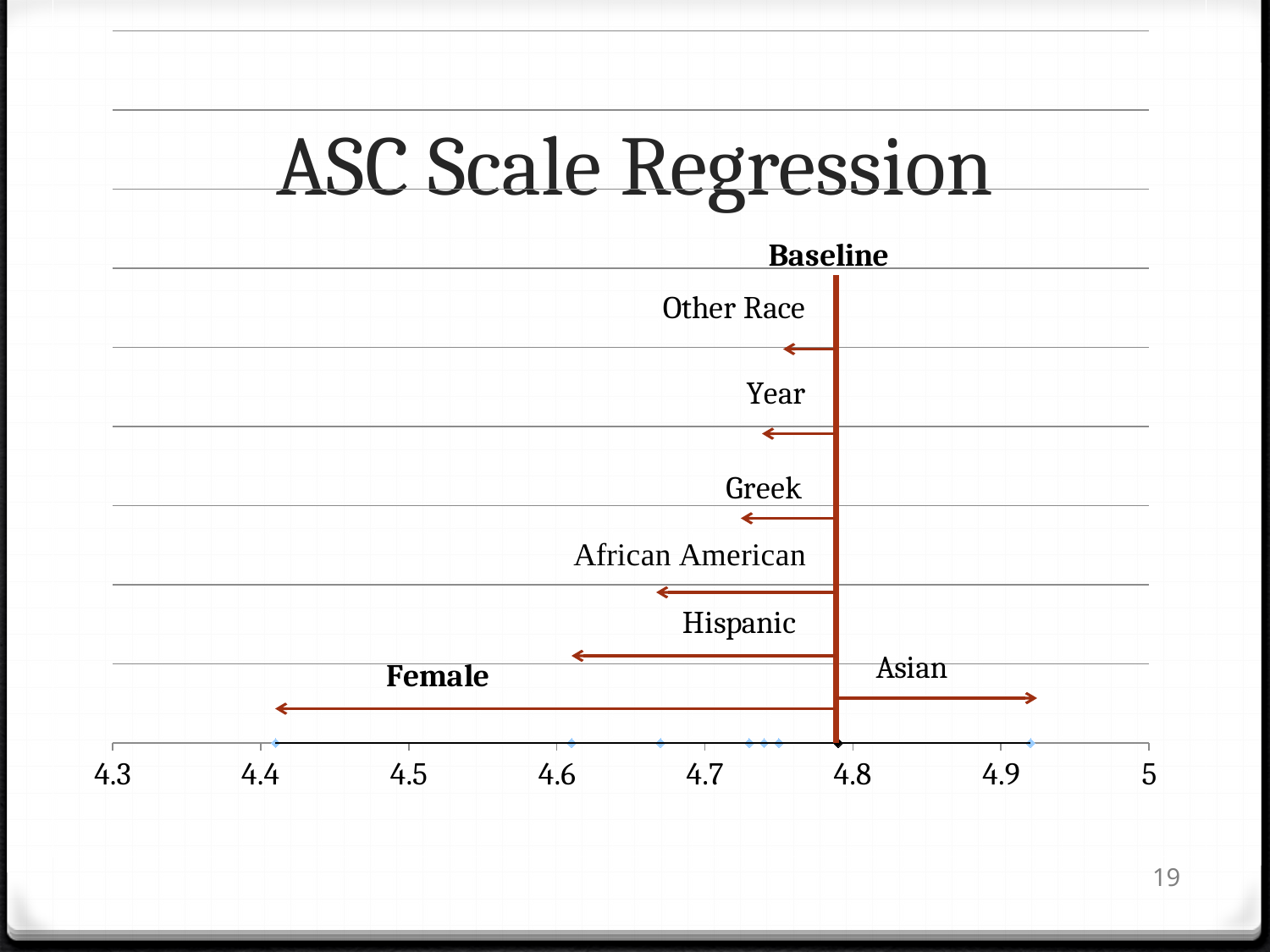
Which predictor has the lowest value on the x axis? Female Is the value for Asian greater or less than 4.8? greater Which has the larger value, Greek or African American? Greek Is the value for Hispanic greater or less than 4.7? less Is the value for Female greater or less than 4.5? less Which predictor has the highest value on the x axis? Asian What is the title of the chart? ASC Scale Regression Which has the larger value, Female or Hispanic? Hispanic How many labelled arrows (predictors) are shown branching from the Baseline? 7 Which is the only predictor whose arrow points to the right of the Baseline? Asian